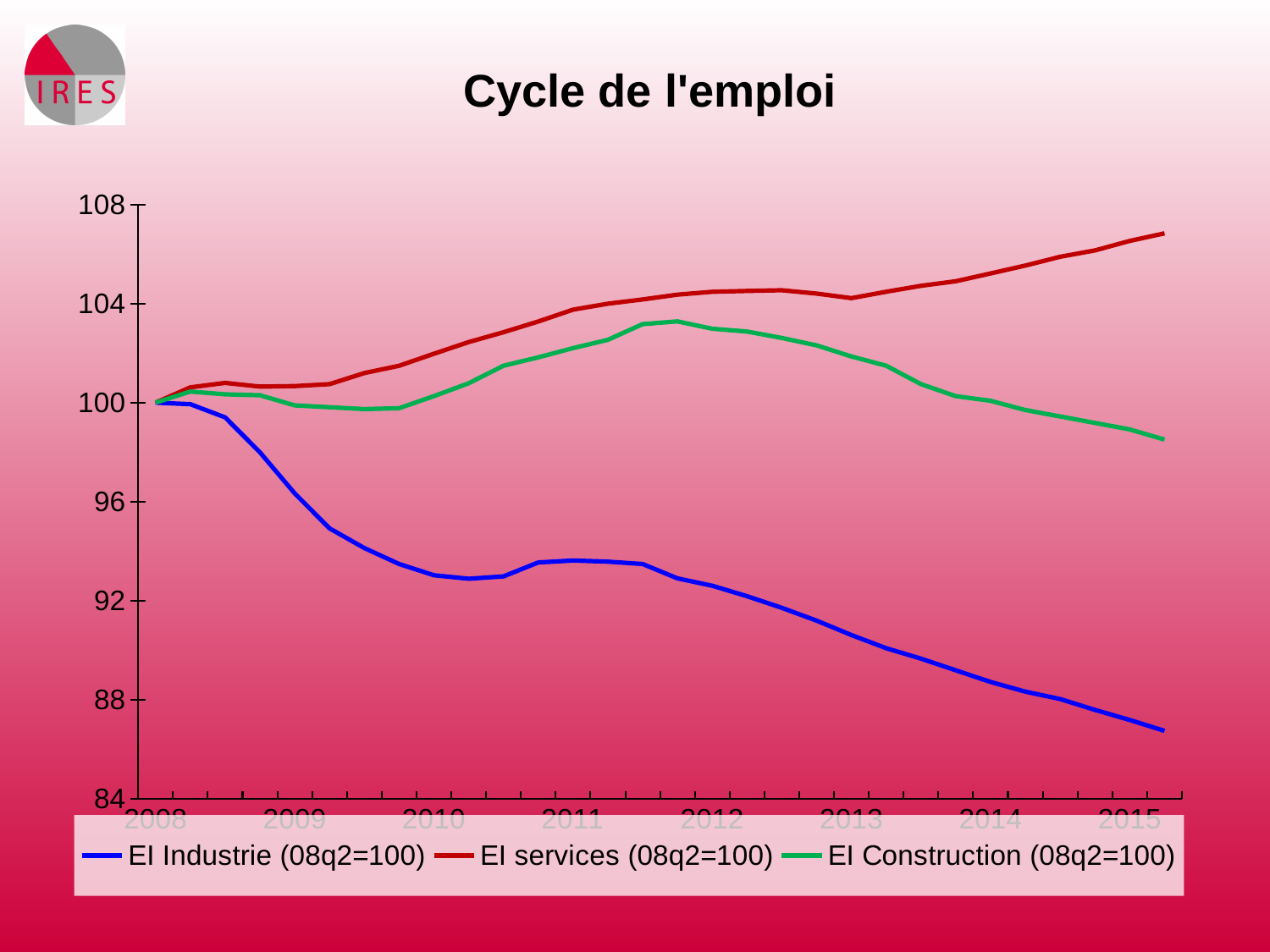
In 2013, which is larger: the value for EI services or the value for EI Construction? EI services Which series has the highest value in 2015? EI services (08q2=100) Is the value for EI services in 2015 greater or less than 104? greater Does the EI Industrie series rise or fall overall from 2008 to 2015? fall Does the EI services series rise or fall overall from 2008 to 2015? rise Which series has the lowest value in 2015? EI Industrie (08q2=100) Is the value for EI Industrie in 2015 greater or less than 88? less What is the title of the chart? Cycle de l'emploi Is the value for EI Construction in 2015 greater or less than 100? less Which series is drawn in blue? EI Industrie (08q2=100) How many series does the legend list? 3 What kind of chart is shown on the slide? line chart